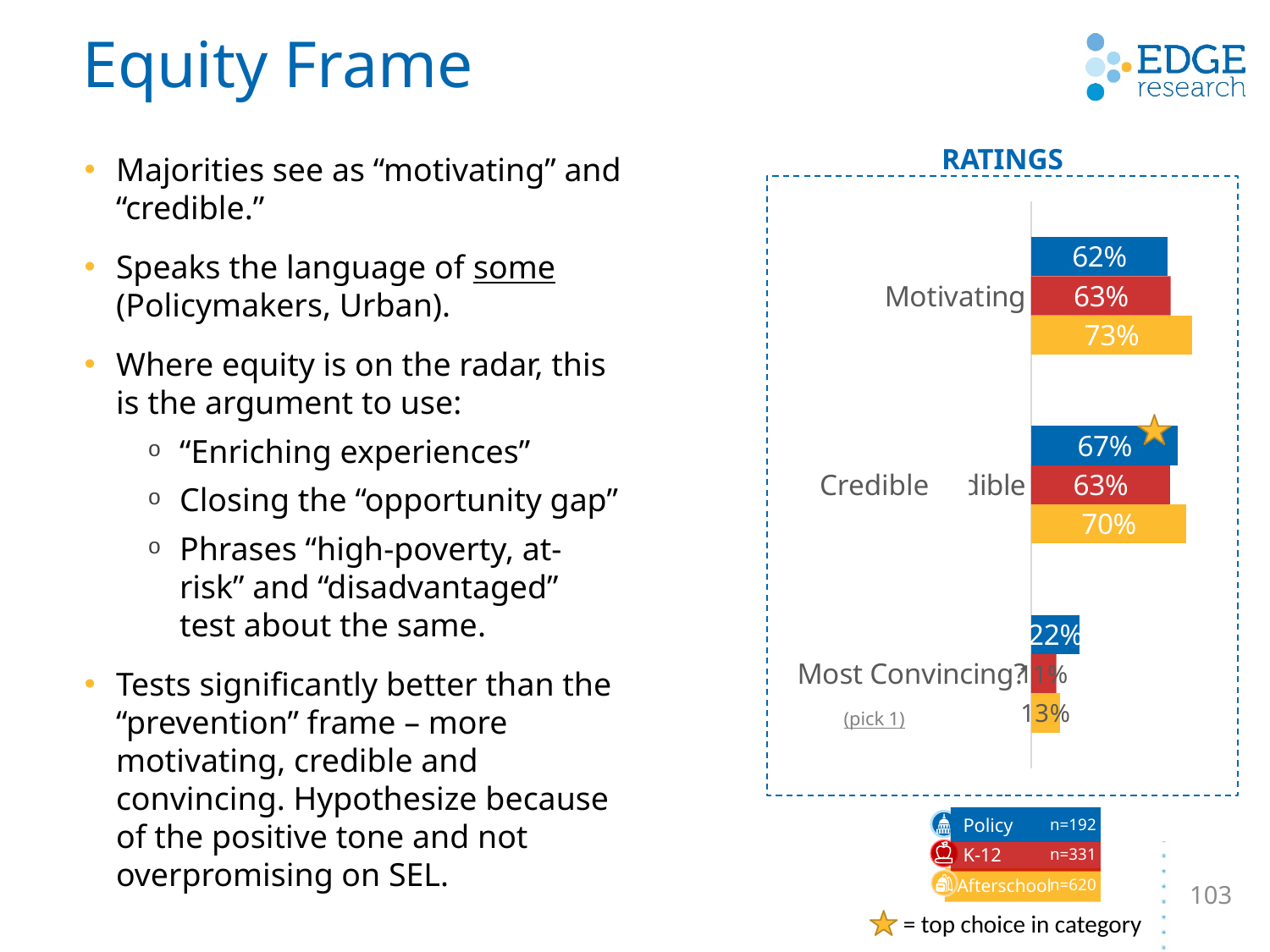
What is the K-12 value for Motivating? 63% How many categories are shown on the chart? 3 How many series does the legend list? 3 What is the difference between the Afterschool and Policy values for Motivating? 11% What kind of chart is shown under the RATINGS heading? bar chart Which group has the lowest value for Credible? K-12 What percentage of the Afterschool group rated the equity frame as Motivating? 73% Which is larger for Credible: the Policy value or the Afterschool value? Afterschool What is the Policy value for Most Convincing? 22% What is the Policy value for Credible? 67% What is the sample size (n) shown for the Afterschool group in the legend? n=620 Which group has the highest value for Motivating? Afterschool